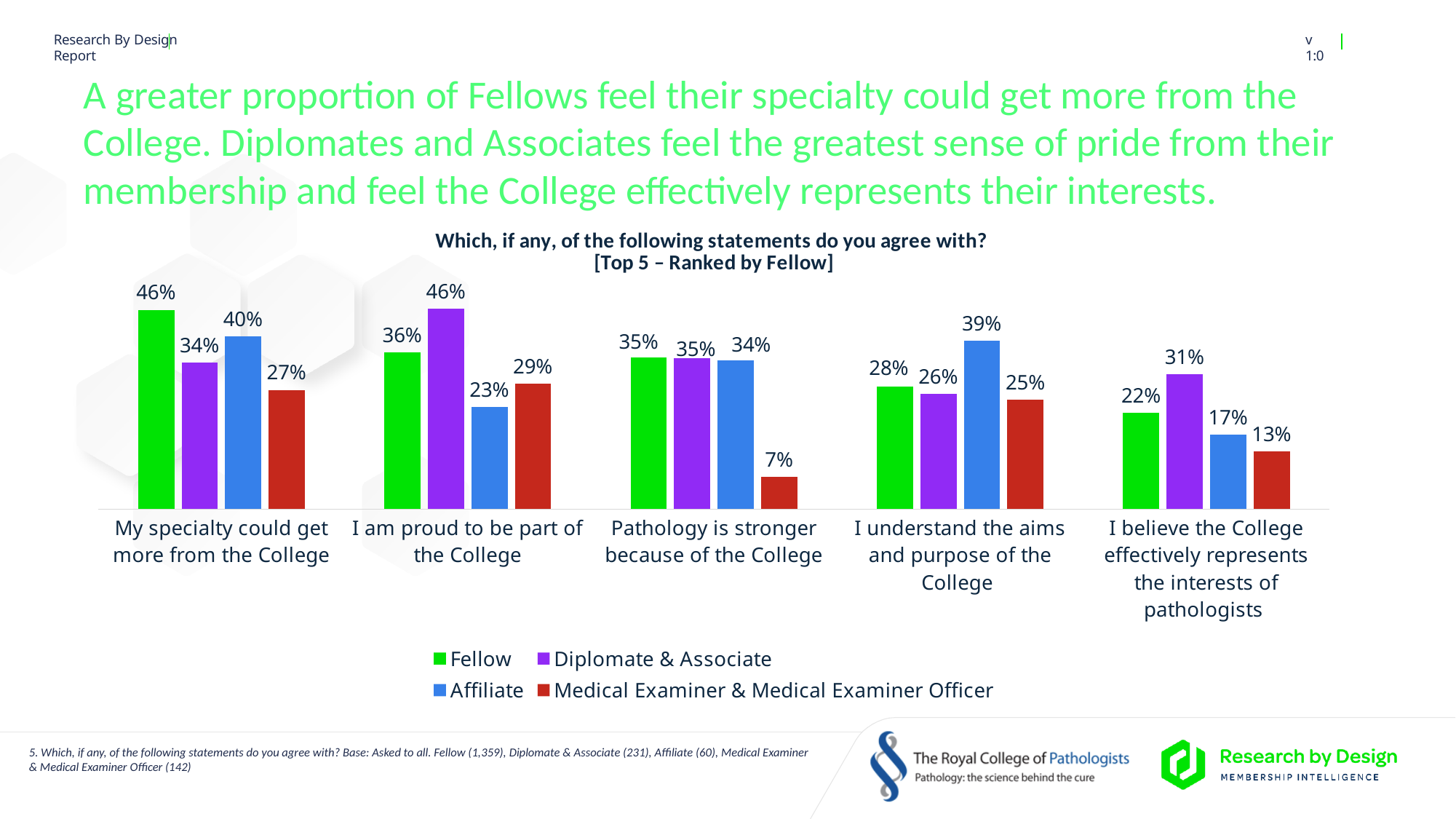
Do the Fellow values rise or fall from left to right across the statements? Fall What kind of chart is shown on the slide? Bar chart Which is larger for 'I am proud to be part of the College': the Fellow value or the Diplomate & Associate value? Diplomate & Associate What is the value for Medical Examiner & Medical Examiner Officer on 'Pathology is stronger because of the College'? 7% Which group has the highest value for 'I believe the College effectively represents the interests of pathologists'? Diplomate & Associate Which group has the lowest value for 'I am proud to be part of the College'? Affiliate How many statements are shown on the x axis of the chart? 5 How many series does the legend list? 4 What is the difference between the Fellow and Affiliate values for 'I believe the College effectively represents the interests of pathologists'? 5% Which colour represents the Affiliate series in the chart? Blue What is the value for Affiliate on 'I understand the aims and purpose of the College'? 39% What percentage of Fellows agree that 'My specialty could get more from the College'? 46%